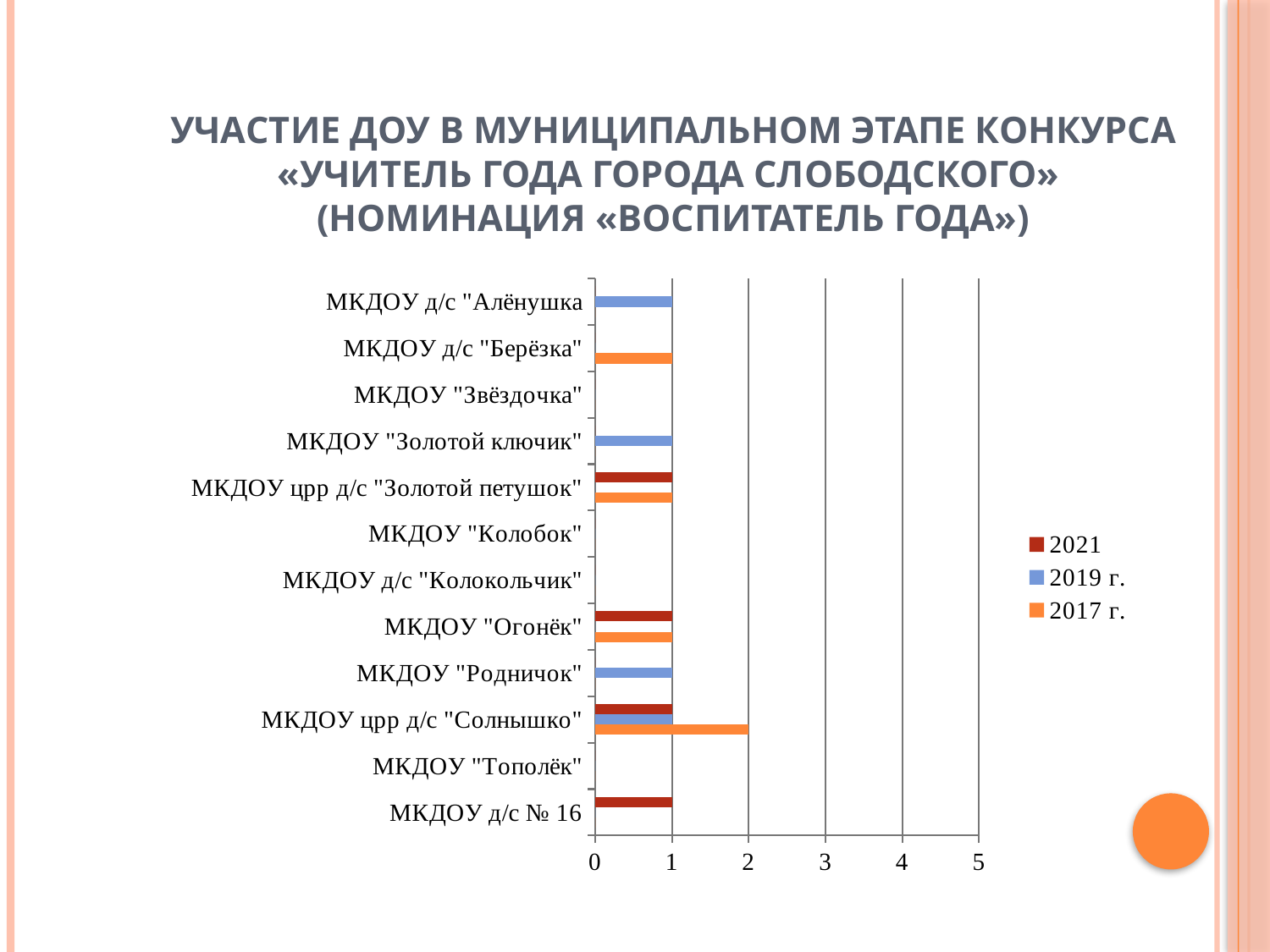
Which category has the highest value in the 2017 г. series? МКДОУ црр д/с "Солнышко" Is the 2017 г. value for МКДОУ црр д/с "Солнышко" greater or less than 3? less Which is larger: the 2017 г. value for МКДОУ црр д/с "Солнышко" or the 2017 г. value for МКДОУ "Огонёк"? МКДОУ црр д/с "Солнышко" What is the difference between the 2017 г. value for МКДОУ црр д/с "Солнышко" and the 2017 г. value for МКДОУ д/с "Берёзка"? 1 How many categories (institutions) are shown on the vertical axis? 12 Which colour represents the 2021 series in the legend? dark red What is the value for МКДОУ д/с № 16 in the 2021 series? 1 What kind of chart is shown on the slide? bar chart What is the value for МКДОУ д/с "Алёнушка" in the 2019 г. series? 1 What is the value for МКДОУ црр д/с "Солнышко" in the 2017 г. series? 2 What is the highest value shown on the horizontal axis? 5 How many series does the legend list? 3